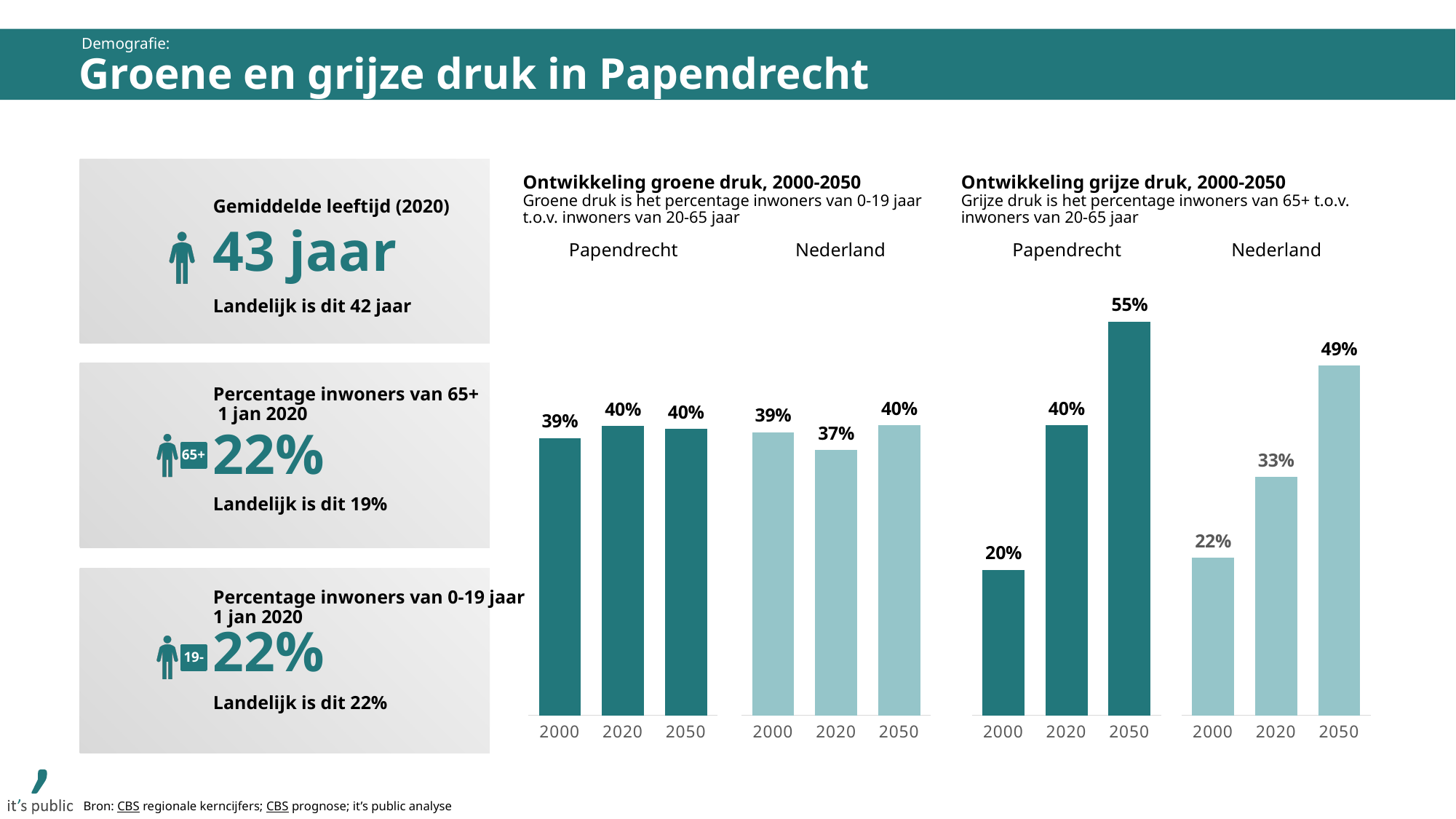
In the 'Ontwikkeling grijze druk, 2000-2050' chart, what is the value for Nederland in 2000? 22% What kind of chart is 'Ontwikkeling grijze druk, 2000-2050'? bar chart In the 'Ontwikkeling groene druk, 2000-2050' chart, what is the value for Nederland in 2020? 37% In the 'Ontwikkeling groene druk, 2000-2050' chart, what is the difference between Papendrecht in 2020 and Nederland in 2020? 3% In the 'Ontwikkeling grijze druk, 2000-2050' chart, which bar is the highest? Papendrecht 2050 In the 'Ontwikkeling grijze druk, 2000-2050' chart, what is the difference between Papendrecht in 2050 and Nederland in 2050? 6% In the 'Ontwikkeling grijze druk, 2000-2050' chart, which bar is the lowest? Papendrecht 2000 In the 'Ontwikkeling grijze druk, 2000-2050' chart, what is the value for Papendrecht in 2050? 55% How many bars are shown in the 'Ontwikkeling groene druk, 2000-2050' chart? 6 In the 'Ontwikkeling groene druk, 2000-2050' chart, what is the value for Papendrecht in 2000? 39% In the 'Ontwikkeling grijze druk, 2000-2050' chart, which is larger: Papendrecht in 2020 or Nederland in 2020? Papendrecht in 2020 In the 'Ontwikkeling grijze druk, 2000-2050' chart, do the values for Papendrecht rise or fall from 2000 to 2050? rise